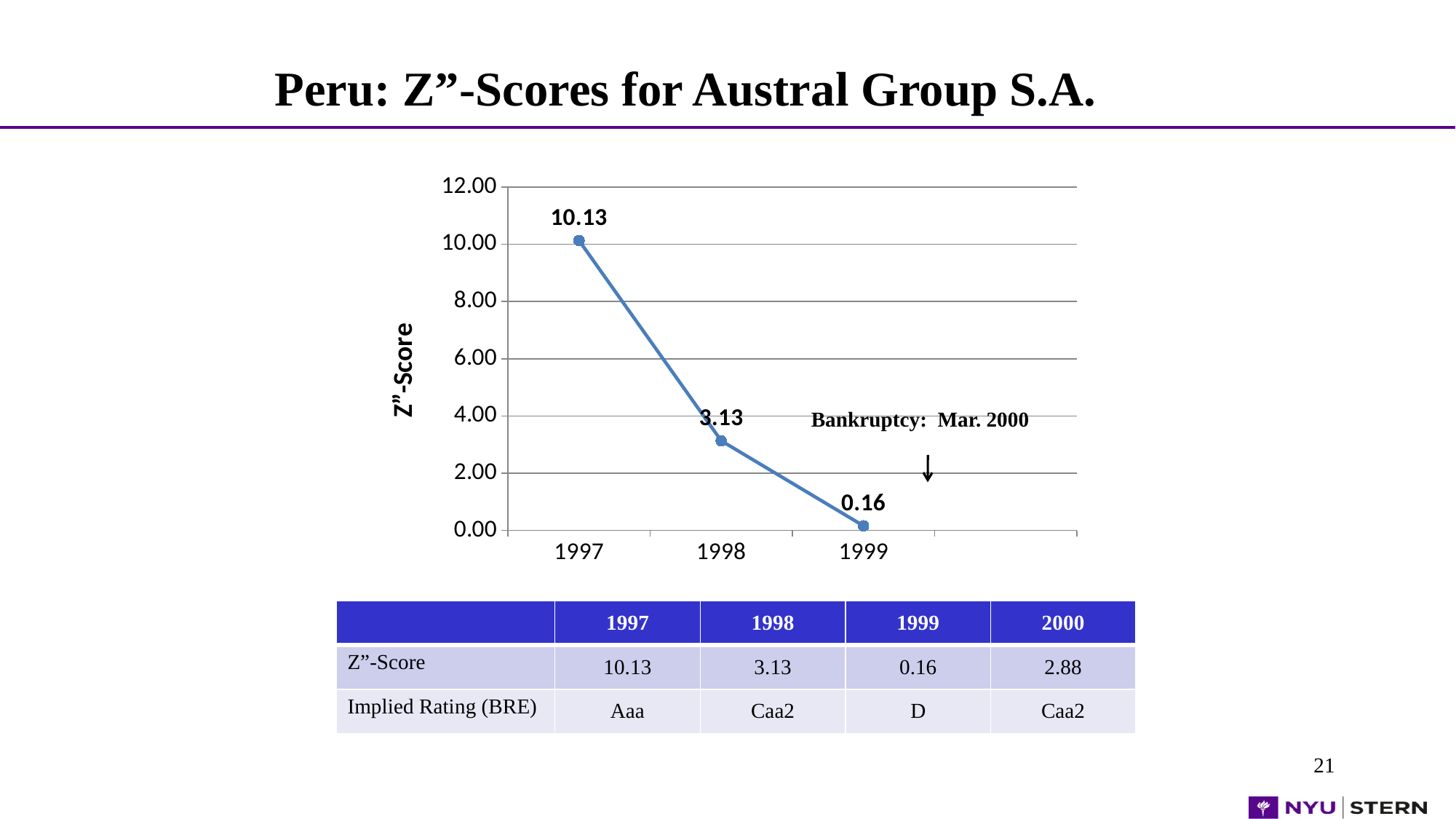
Do the Z"-Scores rise or fall from 1997 to 1999? fall How many data points are plotted on the chart? 3 Which is larger, the Z"-Score for 1998 or the Z"-Score for 1999? 1998 What is the difference between the Z"-Score for 1997 and the Z"-Score for 1998? 7.00 Which year has the highest Z"-Score on the chart? 1997 What is the Z"-Score plotted for 1999? 0.16 What is the difference between the Z"-Score for 1998 and the Z"-Score for 1999? 2.97 What kind of chart is shown on the slide? line chart Which year has the lowest Z"-Score on the chart? 1999 What is the Z"-Score plotted for 1998? 3.13 Is the Z"-Score for 1998 greater or less than 4.00? less What is the Z"-Score plotted for 1997? 10.13